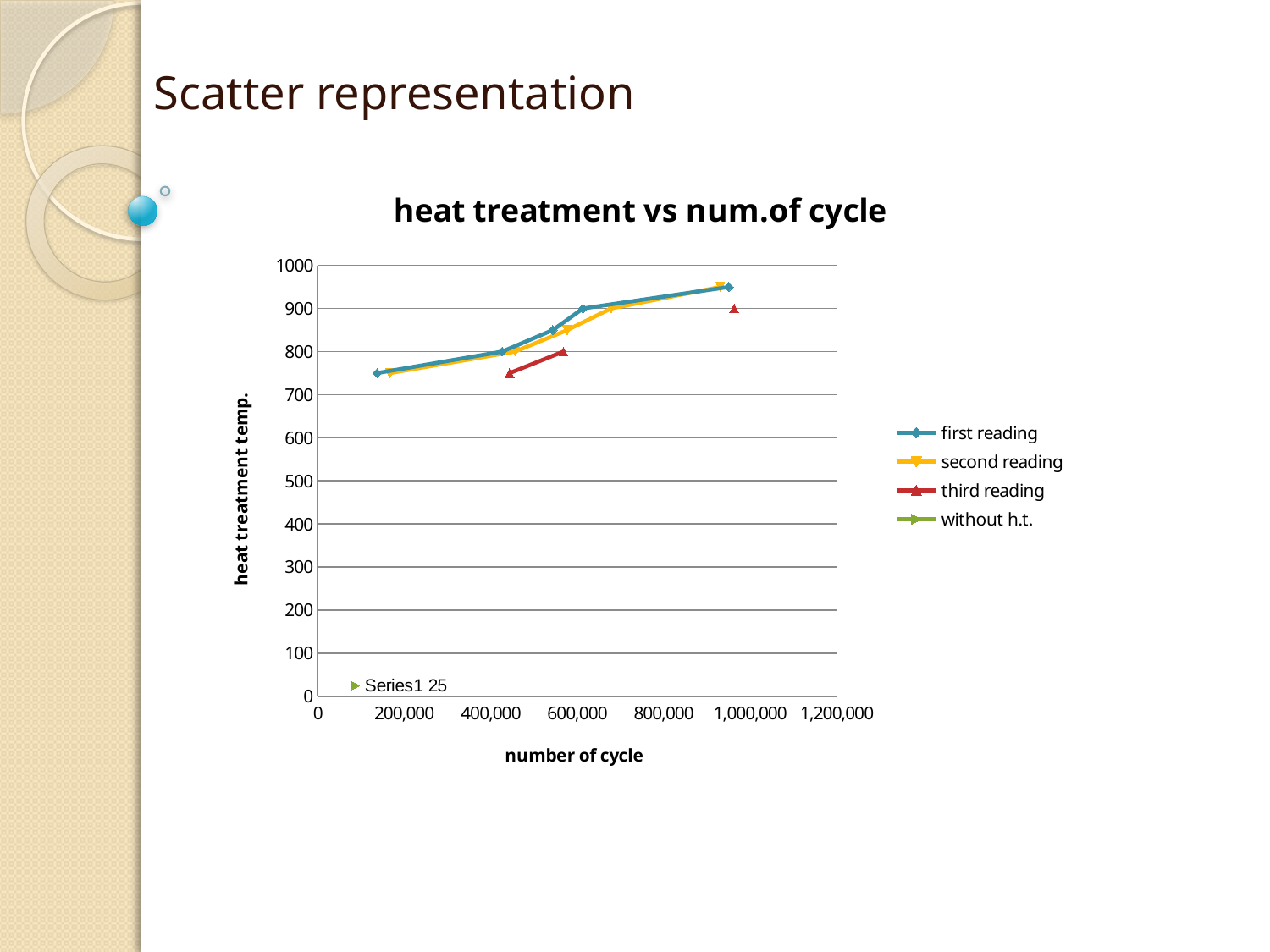
What is the label of the x axis? number of cycle Do the values for the first reading series rise or fall as the number of cycles increases? rise How many series does the chart legend list? 4 What kind of chart is shown on the slide? scatter chart Is the first point of the third reading series greater or less than 800? less What is the title of the chart? heat treatment vs num.of cycle Is the lowest value of the first reading series greater or less than 800? less Which series has the lowest plotted value on the chart? without h.t. Is the highest value of the first reading series greater or less than 900? greater What value is printed in the data label near the bottom left of the plot area? 25 How many data points are plotted for the third reading series? 3 Near 1,000,000 cycles, which series has the higher value: first reading or third reading? first reading